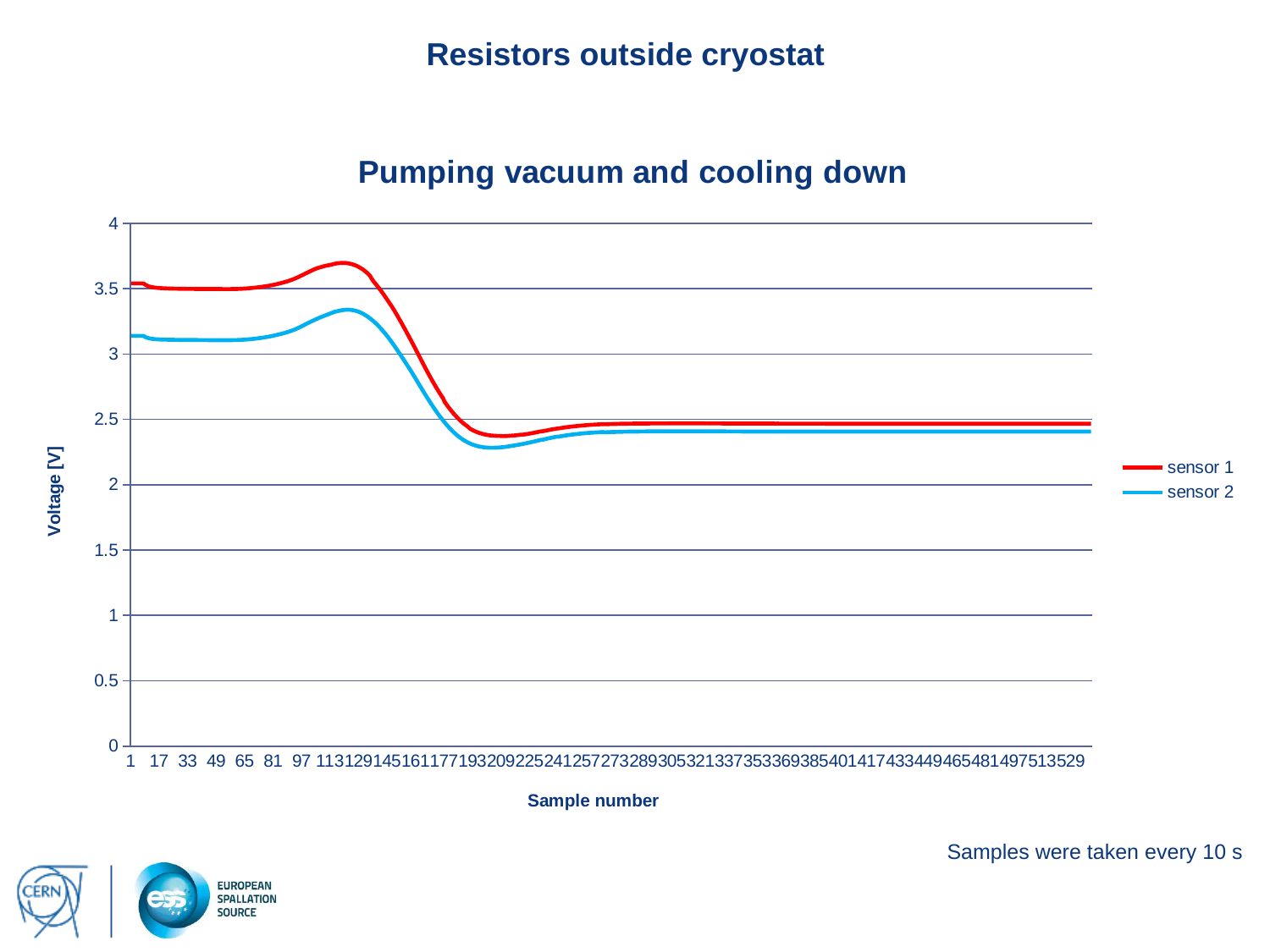
What is the label of the vertical axis? Voltage [V] Which series has the higher voltage throughout the chart, sensor 1 or sensor 2? sensor 1 Overall, do the voltages rise or fall from the first sample to the last sample? fall What kind of chart is shown on the slide? line chart Is the value of sensor 2 at sample 1 greater or less than 3? greater Is the peak value of sensor 1 greater or less than 3.5? greater Which series is plotted in red? sensor 1 Is the value of sensor 1 at sample 529 greater or less than 3? less What is the title of the chart? Pumping vacuum and cooling down How many series does the legend list? 2